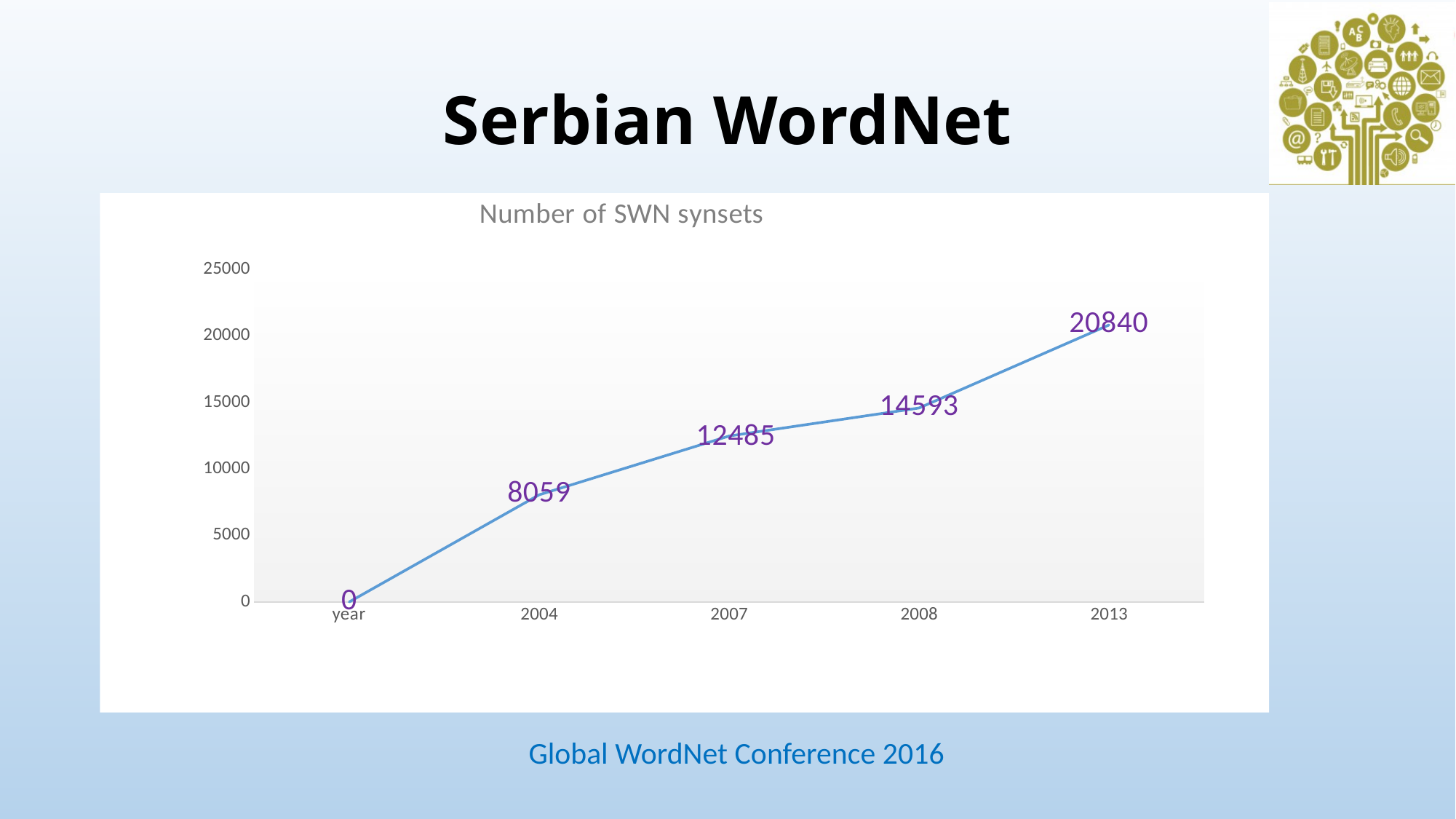
How many data points are plotted on the line? 5 What is the number of SWN synsets in 2007? 12485 What is the number of SWN synsets in 2013? 20840 Do the values rise or fall along the x axis? rise What is the difference in the number of SWN synsets between 2007 and 2004? 4426 What is the number of SWN synsets in 2004? 8059 What is the number of SWN synsets in 2008? 14593 Which year has the highest number of SWN synsets? 2013 What kind of chart is shown on the slide? line chart What is the difference in the number of SWN synsets between 2013 and 2008? 6247 Which x-axis category has the lowest value? year Which is larger, the value for 2007 or the value for 2008? 2008